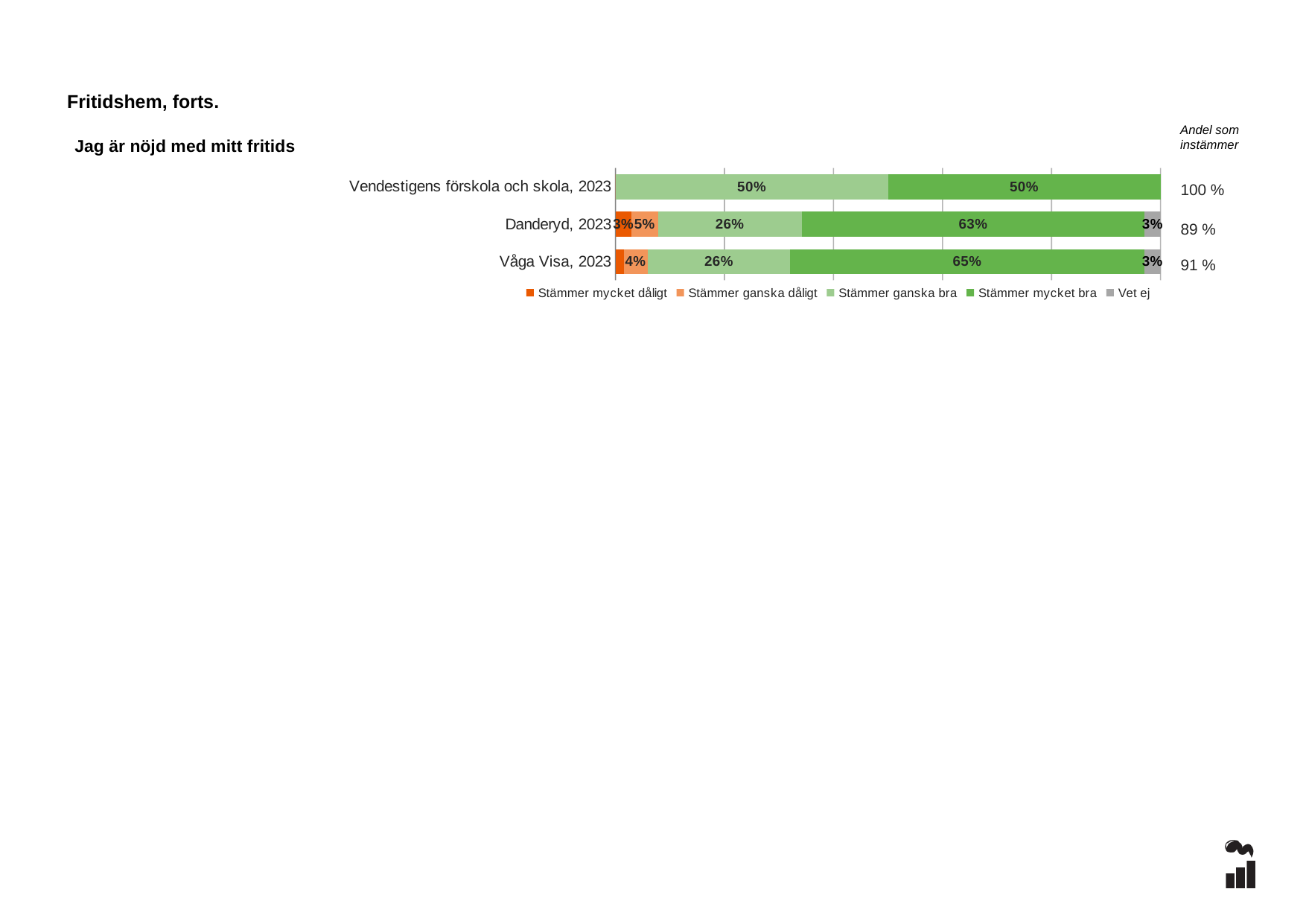
What is the value for 'Stämmer mycket bra' for Danderyd, 2023? 63% What is the 'Andel som instämmer' value shown for Danderyd, 2023? 89 % Which category has the highest value for 'Stämmer mycket bra'? Våga Visa, 2023 What kind of chart is shown on the slide? Stacked bar chart What is the value for 'Stämmer ganska bra' for Vendestigens förskola och skola, 2023? 50% How many categories (bars) are shown in the chart? 3 What is the title of the chart? Jag är nöjd med mitt fritids What is the difference between the 'Stämmer mycket bra' values for Våga Visa, 2023 and Danderyd, 2023? 2% What is the value for 'Vet ej' for Danderyd, 2023? 3% What is the value for 'Stämmer ganska dåligt' for Våga Visa, 2023? 4% Which is larger: the 'Stämmer ganska bra' value for Vendestigens förskola och skola, 2023 or for Danderyd, 2023? Vendestigens förskola och skola, 2023 How many series does the legend list? 5